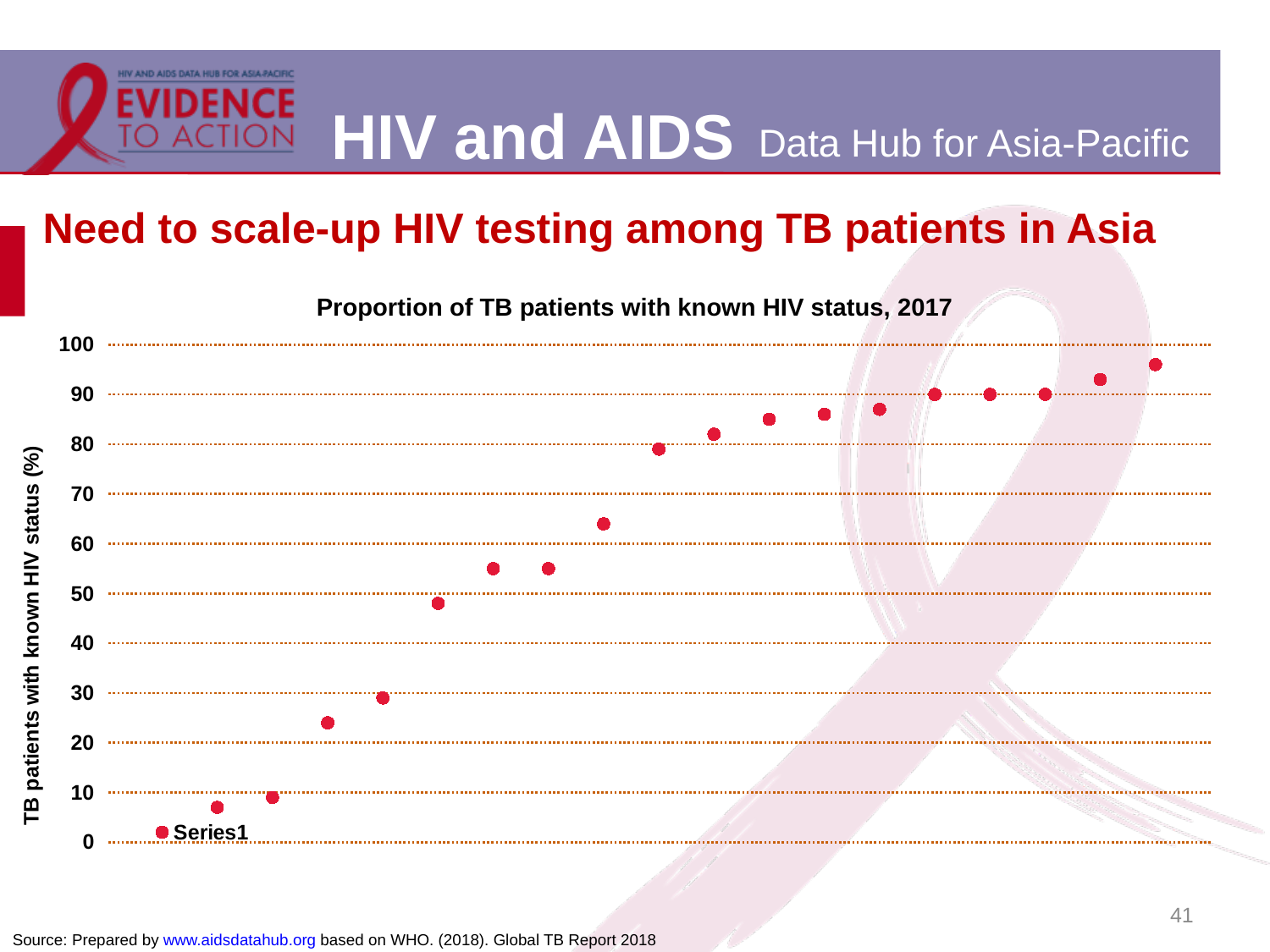
What is the maximum value shown on the vertical axis? 100 Is the value of the rightmost point greater or less than 90? greater What is the title of the chart? Proportion of TB patients with known HIV status, 2017 Is the value of the leftmost point greater or less than 10? less Which point has the highest value, the leftmost or the rightmost? rightmost Is the value of the rightmost point greater or less than 100? less Do the plotted values rise or fall from left to right along the x axis? rise What kind of chart is shown on the slide? scatter chart How many series does the chart legend list? 1 What is the label on the vertical axis of the chart? TB patients with known HIV status (%) How many data points are plotted on the chart? 19